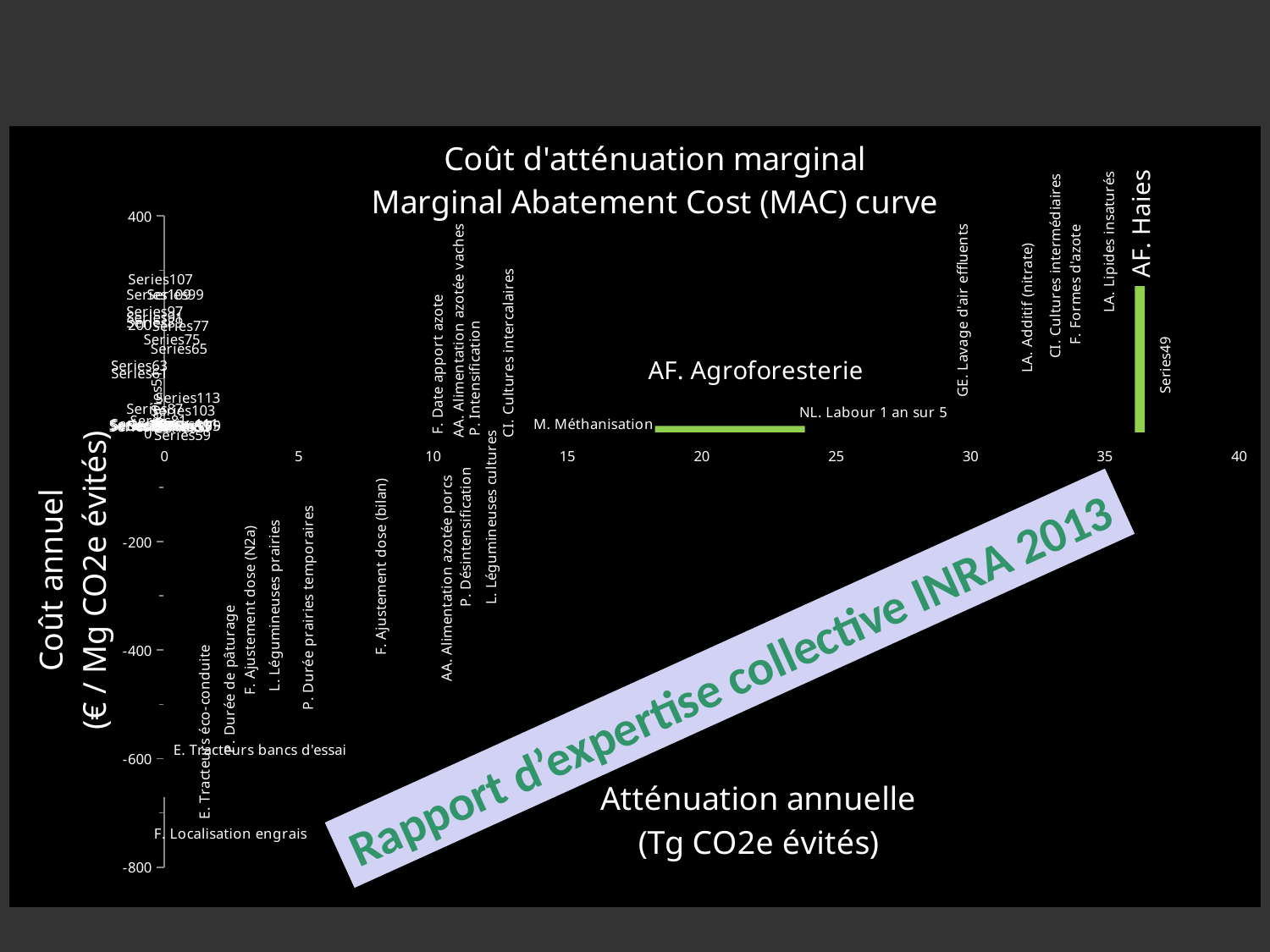
What kind of chart is shown on the slide? bar chart Is the horizontal green bar next to the label M. Méthanisation positioned at an x-axis value greater or less than 15? greater Which labelled measure appears lowest on the chart, near the bottom of the y axis? F. Localisation engrais Is the top of the green bar labelled AF. Haies greater or less than 200 on the y axis? greater What is the highest value shown on the y axis of the chart? 400 Is the label E. Tracteurs bancs d'essai positioned above or below -400 on the y axis? below What is the highest value shown on the x axis of the chart? 40 What is the lowest value shown on the y axis of the chart? -800 What is the title of the chart? Coût d'atténuation marginal / Marginal Abatement Cost (MAC) curve